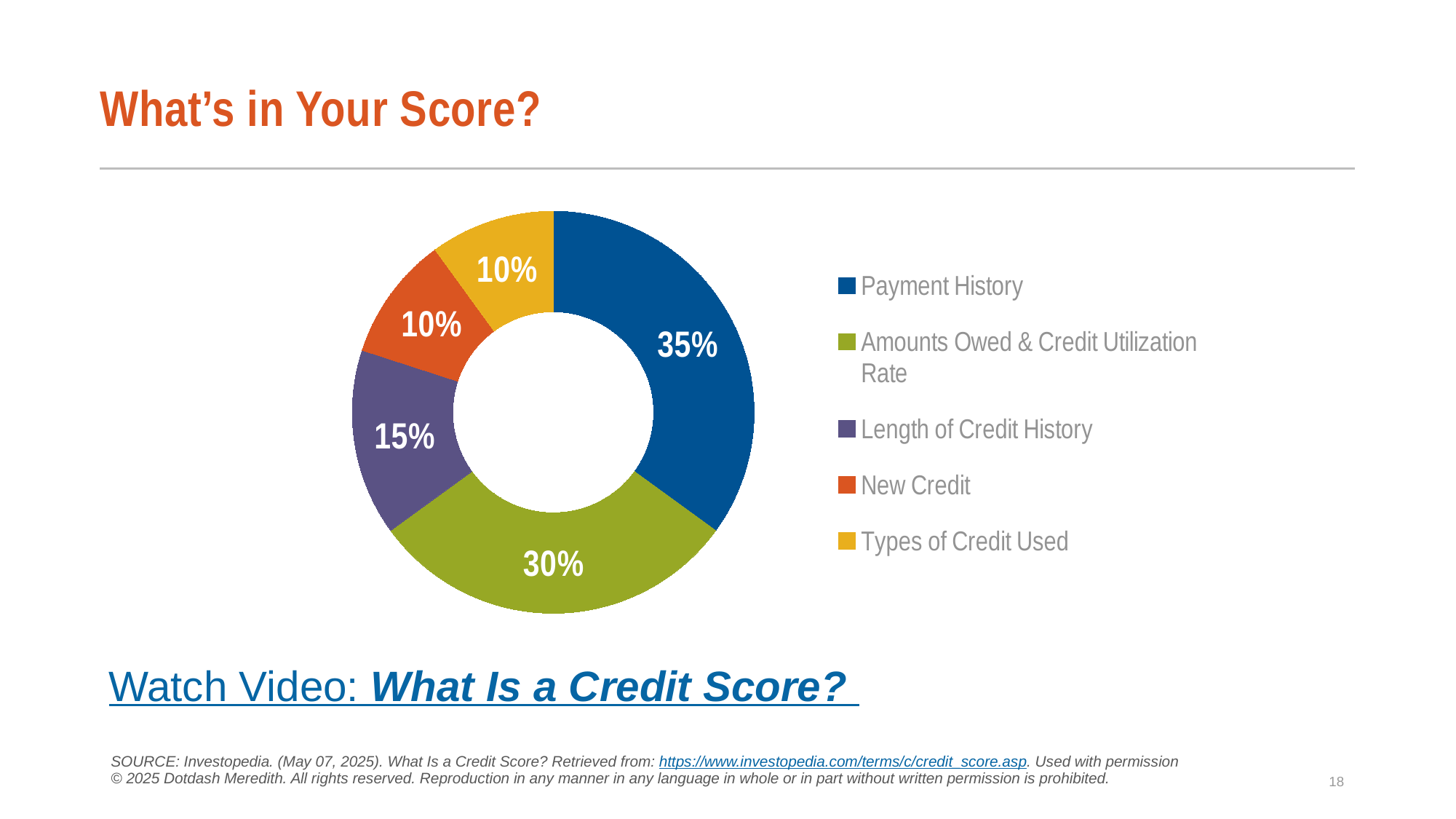
Which category has the largest share of the score? Payment History What percentage is shown for Amounts Owed & Credit Utilization Rate? 30% What kind of chart is shown on the slide? Pie chart (doughnut) What percentage is shown for New Credit? 10% Which category is shown in blue? Payment History What is the combined share of New Credit and Types of Credit Used? 20% What percentage is shown for Length of Credit History? 15% What is the difference in percentage points between Payment History and Amounts Owed & Credit Utilization Rate? 5 What share of the score does Payment History account for? 35% What is the title of the slide containing the chart? What's in Your Score? Which is larger, Length of Credit History or Types of Credit Used? Length of Credit History How many categories are shown in the chart? 5